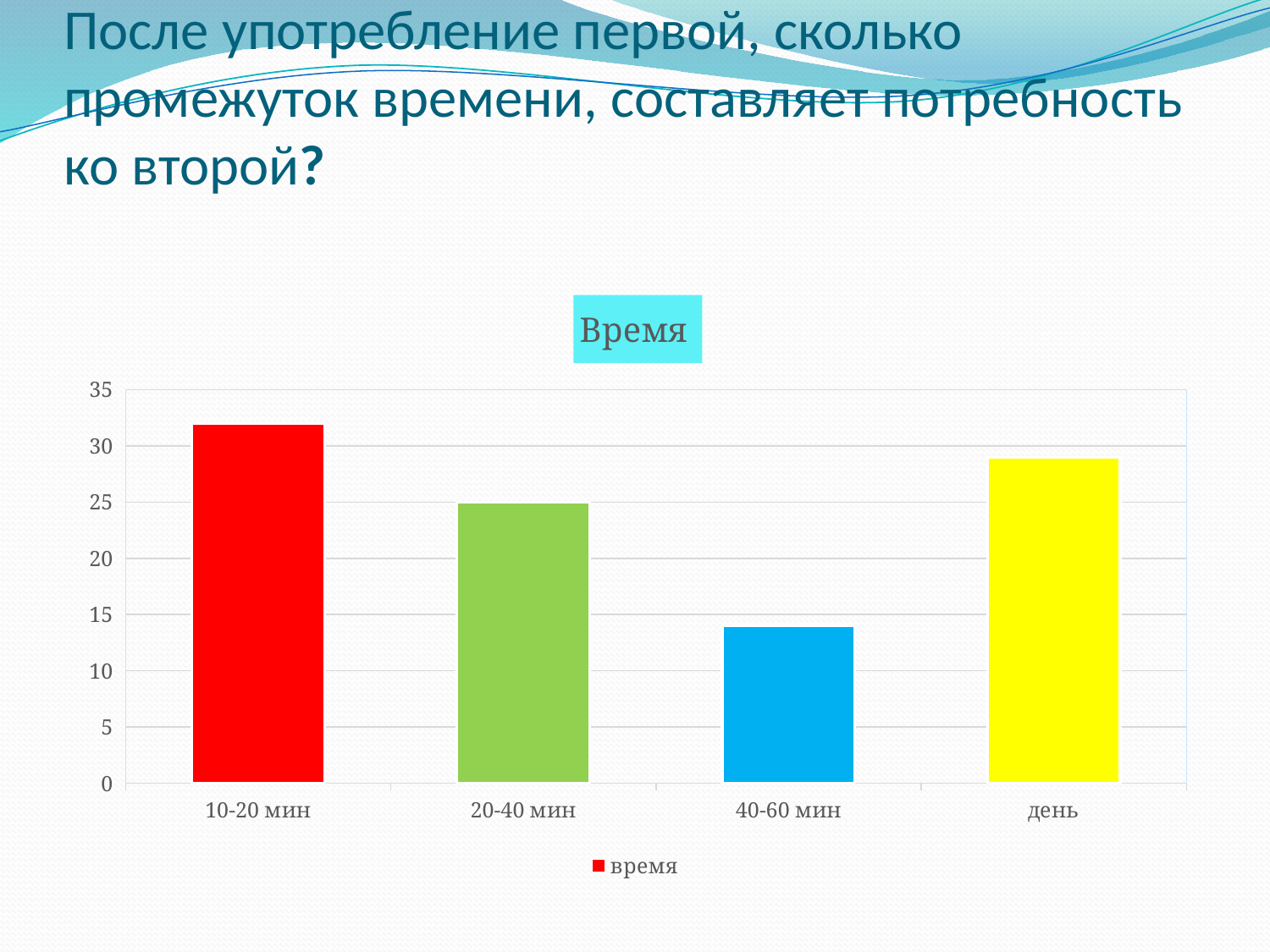
What kind of chart is shown on the slide? bar chart Is the value for 20-40 мин greater or less than 20? greater Which is larger, the value for день or the value for 20-40 мин? день How many categories are shown on the x axis of the chart? 4 Is the value for 10-20 мин greater or less than 30? greater Is the value for 40-60 мин greater or less than 15? less What colour is the bar for 40-60 мин? blue Which category has the lowest value? 40-60 мин Which category has the highest value? 10-20 мин How many series does the legend list? 1 What is the title of the chart? Время